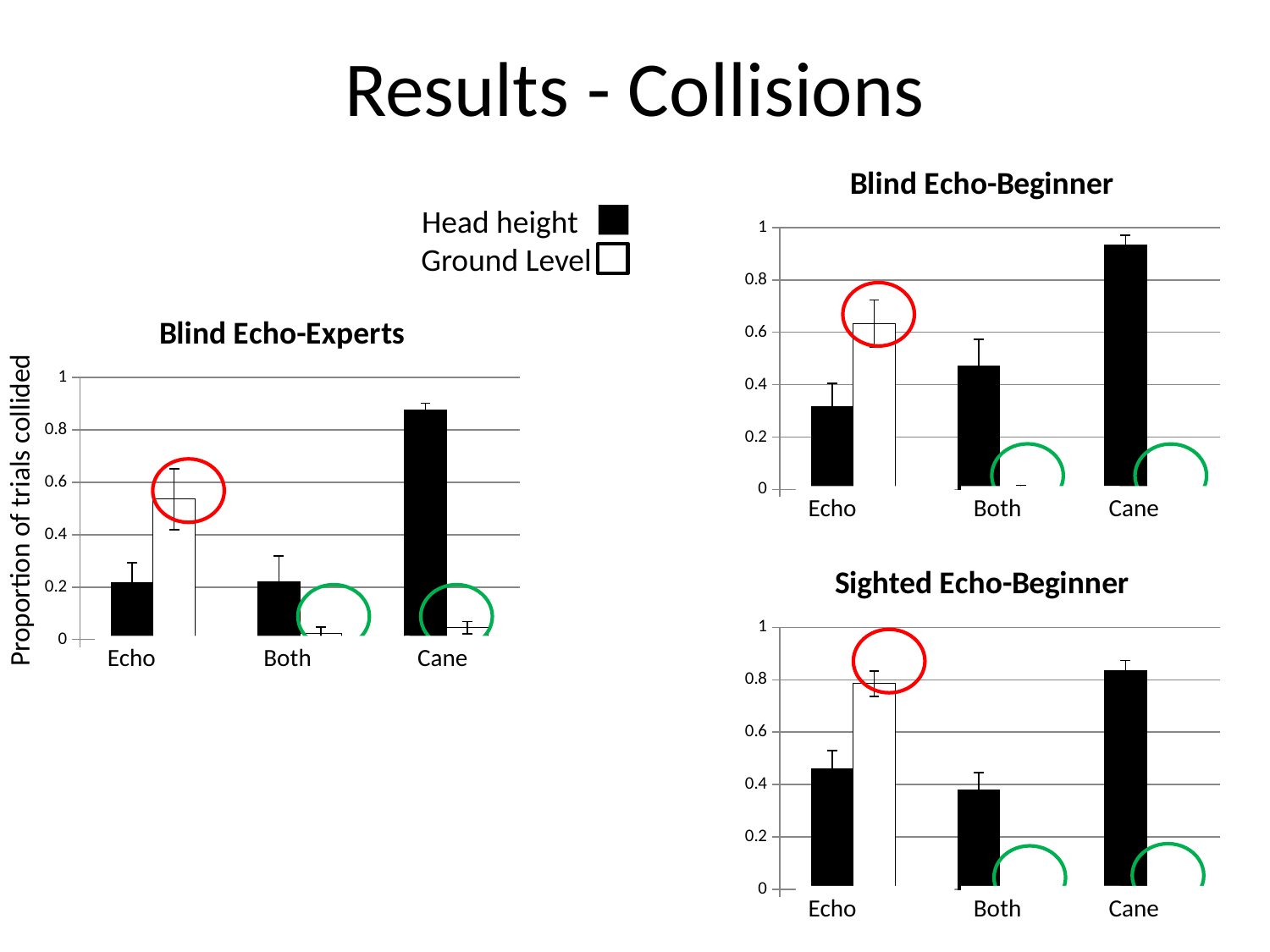
In the "Blind Echo-Beginner" chart, which is larger for Echo: the Head height bar or the Ground Level bar? Ground Level In the "Blind Echo-Experts" chart, is the Head height value for Cane greater or less than 0.8? greater How many categories are shown on the x axis of the "Sighted Echo-Beginner" chart? 3 In the "Blind Echo-Beginner" chart, is the Ground Level value for Echo greater or less than 0.4? greater What is the y-axis label shown on the "Blind Echo-Experts" chart? Proportion of trials collided How many series does the legend list for the charts on this slide? 2 Which series is shown with black bars according to the legend? Head height In the "Blind Echo-Beginner" chart, is the Head height value for Cane greater or less than 0.8? greater What kind of chart is the "Blind Echo-Experts" chart? bar chart In the "Sighted Echo-Beginner" chart, which category has the highest Head height bar? Cane In the "Blind Echo-Experts" chart, which category has the highest Head height bar? Cane